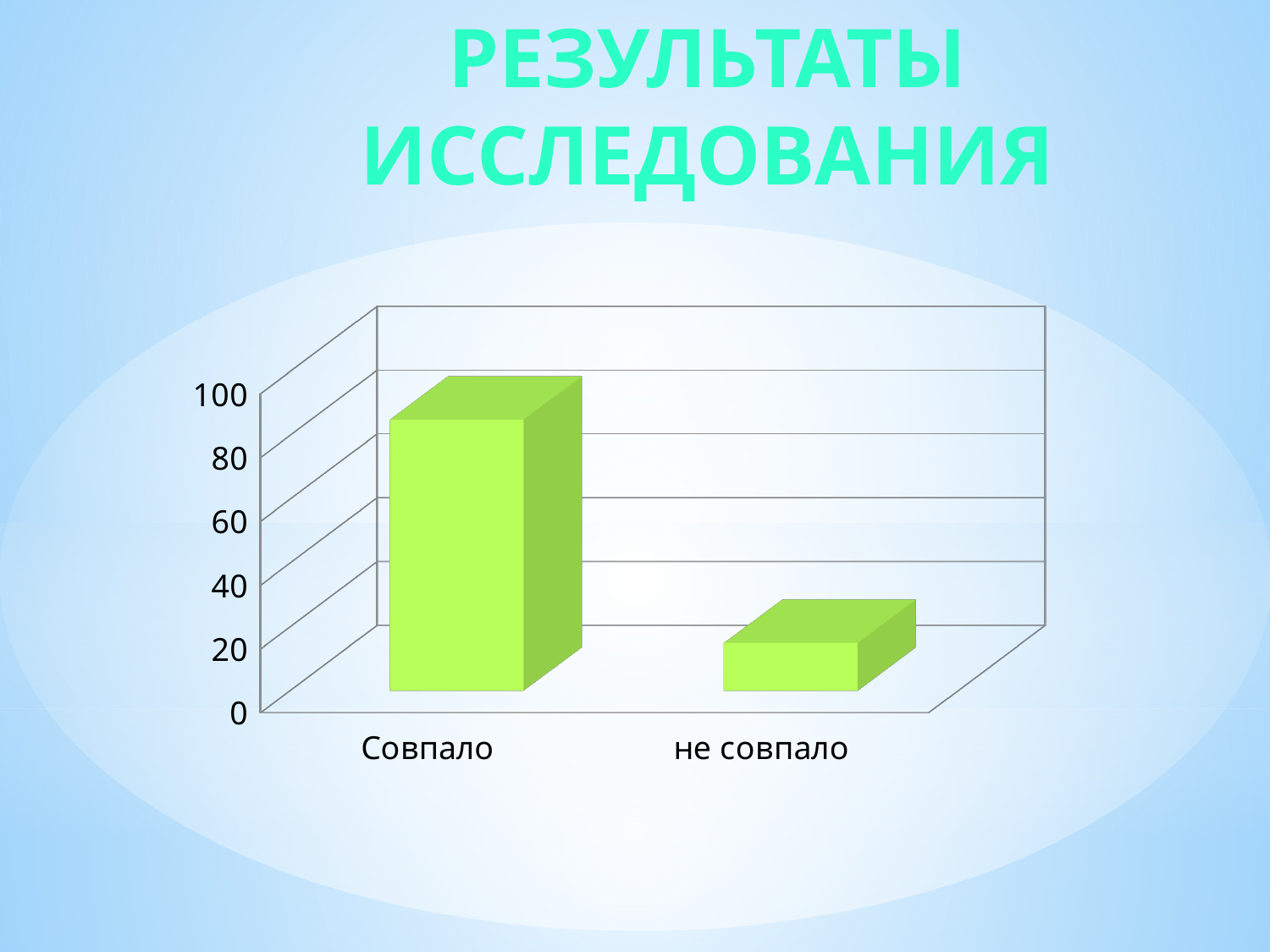
Which is larger, the value for Совпало or the value for не совпало? Совпало Which category has the highest bar in the chart? Совпало What is the title of the slide containing the chart? РЕЗУЛЬТАТЫ ИССЛЕДОВАНИЯ What is the highest value labelled on the vertical axis of the chart? 100 What kind of chart is shown on the slide? bar chart Is the value for Совпало greater or less than 60? greater How many categories are shown on the x axis of the chart? 2 Is the value for Совпало greater or less than 40? greater Is the value for не совпало greater or less than 40? less Which category has the lowest bar in the chart? не совпало